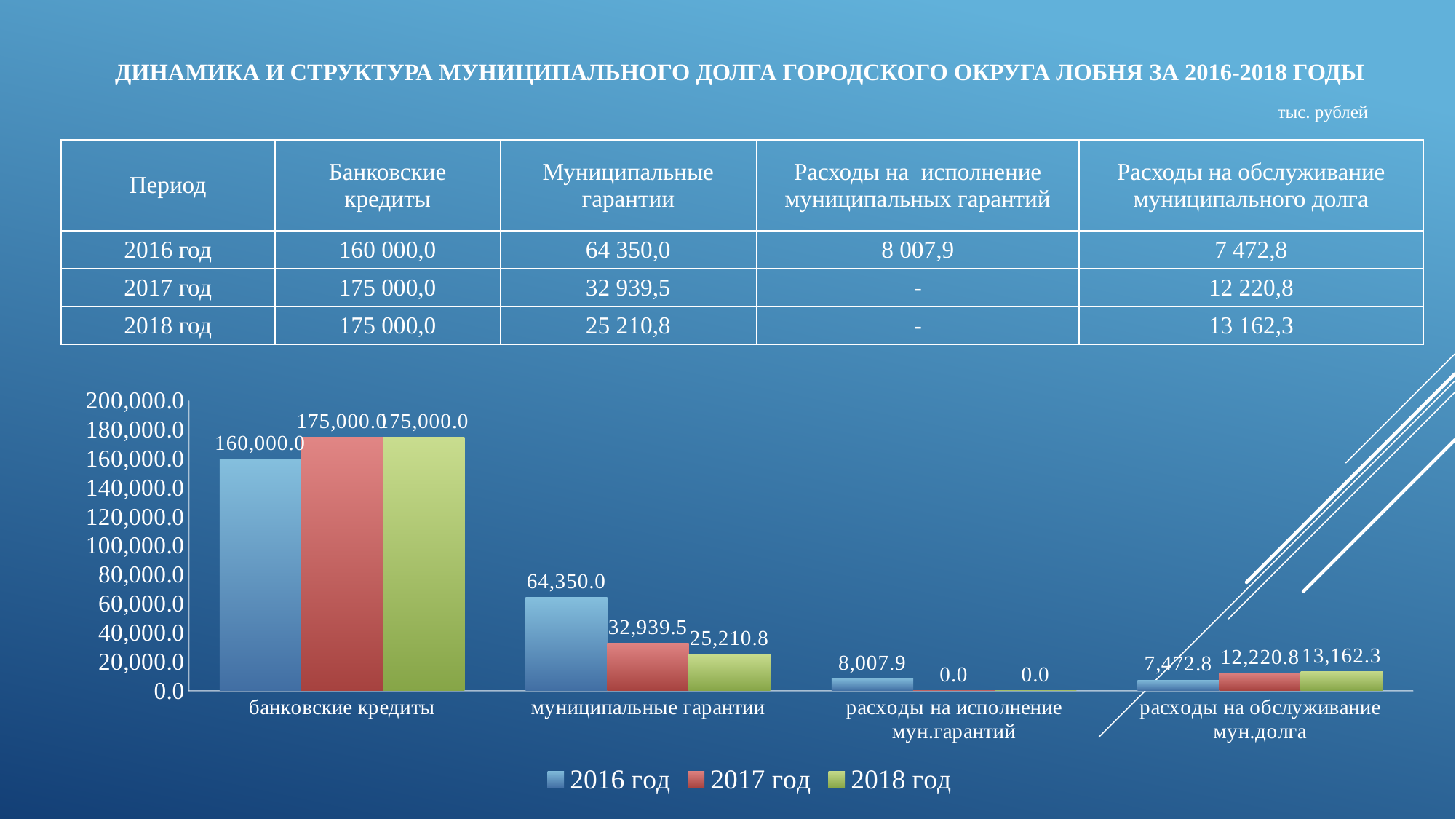
What is the value for 2016 год in the муниципальные гарантии category? 64,350.0 How many categories are shown on the x axis of the chart? 4 Which year has the highest value in the муниципальные гарантии category? 2016 год Which year has the lowest value in the расходы на обслуживание мун.долга category? 2016 год What is the value for 2017 год in the банковские кредиты category? 175,000.0 What is the difference between the 2016 год and 2017 год values in the муниципальные гарантии category? 31,410.5 How many series does the chart legend list? 3 What is the value for 2016 год in the расходы на исполнение мун.гарантий category? 8,007.9 Do the values for муниципальные гарантии rise or fall from 2016 год to 2018 год? fall Which is larger: the 2016 год value for банковские кредиты or the 2018 год value for банковские кредиты? 2018 год What is the difference between the 2018 год and 2016 год values in the расходы на обслуживание мун.долга category? 5,689.5 What is the value for 2018 год in the расходы на обслуживание мун.долга category? 13,162.3